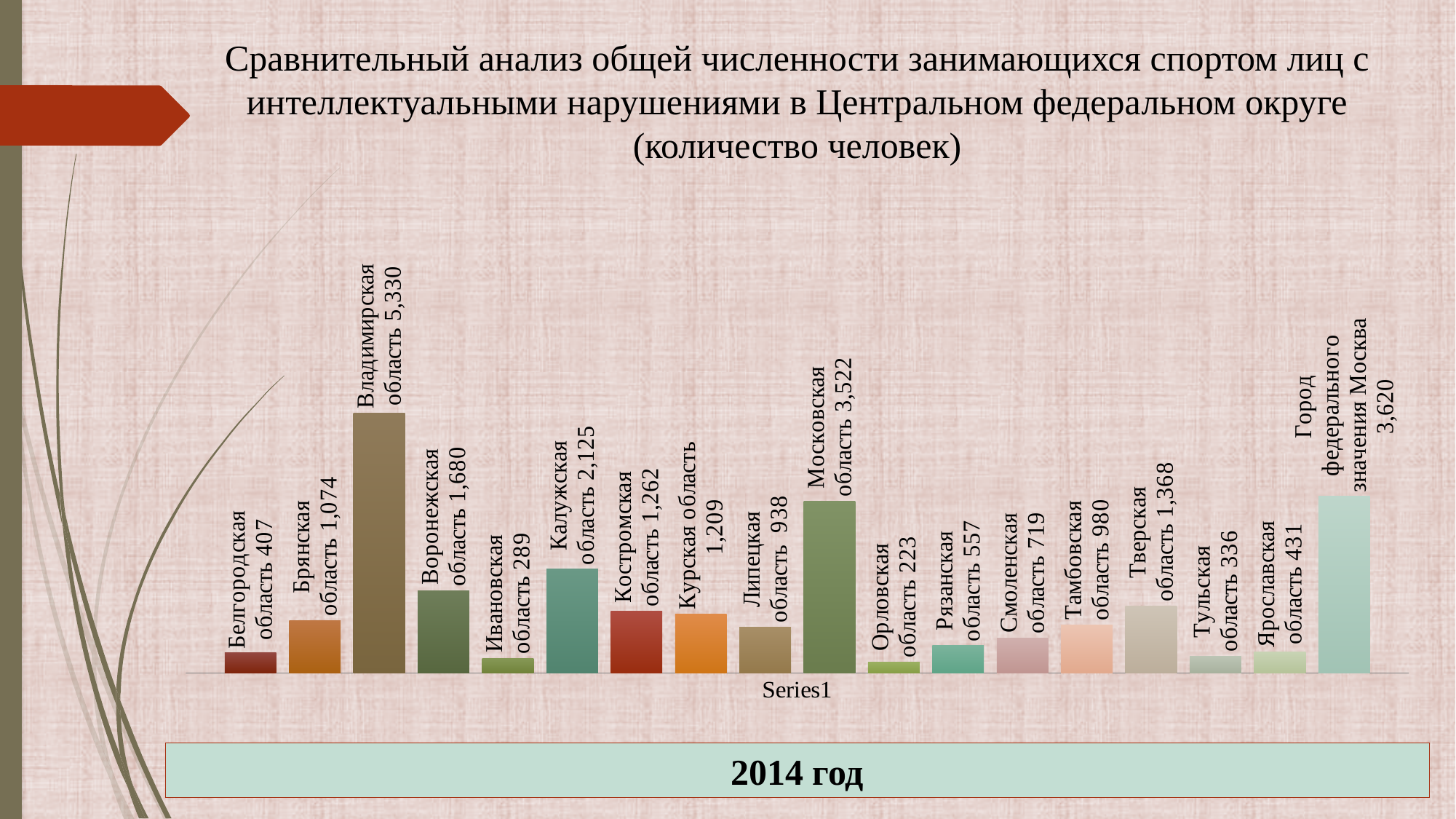
What is the difference between the values for Калужская область and Воронежская область? 445 How many regions (bars) are shown in the chart? 18 What is the value for Владимирская область? 5,330 What year is indicated in the box below the chart? 2014 год What is the difference between the values for Город федерального значения Москва and Московская область? 98 What is the value for Город федерального значения Москва? 3,620 Which has a larger value, Тверская область or Брянская область? Тверская область What is the value for Липецкая область? 938 Which region has the highest value in the chart? Владимирская область What kind of chart is shown on the slide? bar chart Which region has the lowest value in the chart? Орловская область What is the value for Смоленская область? 719